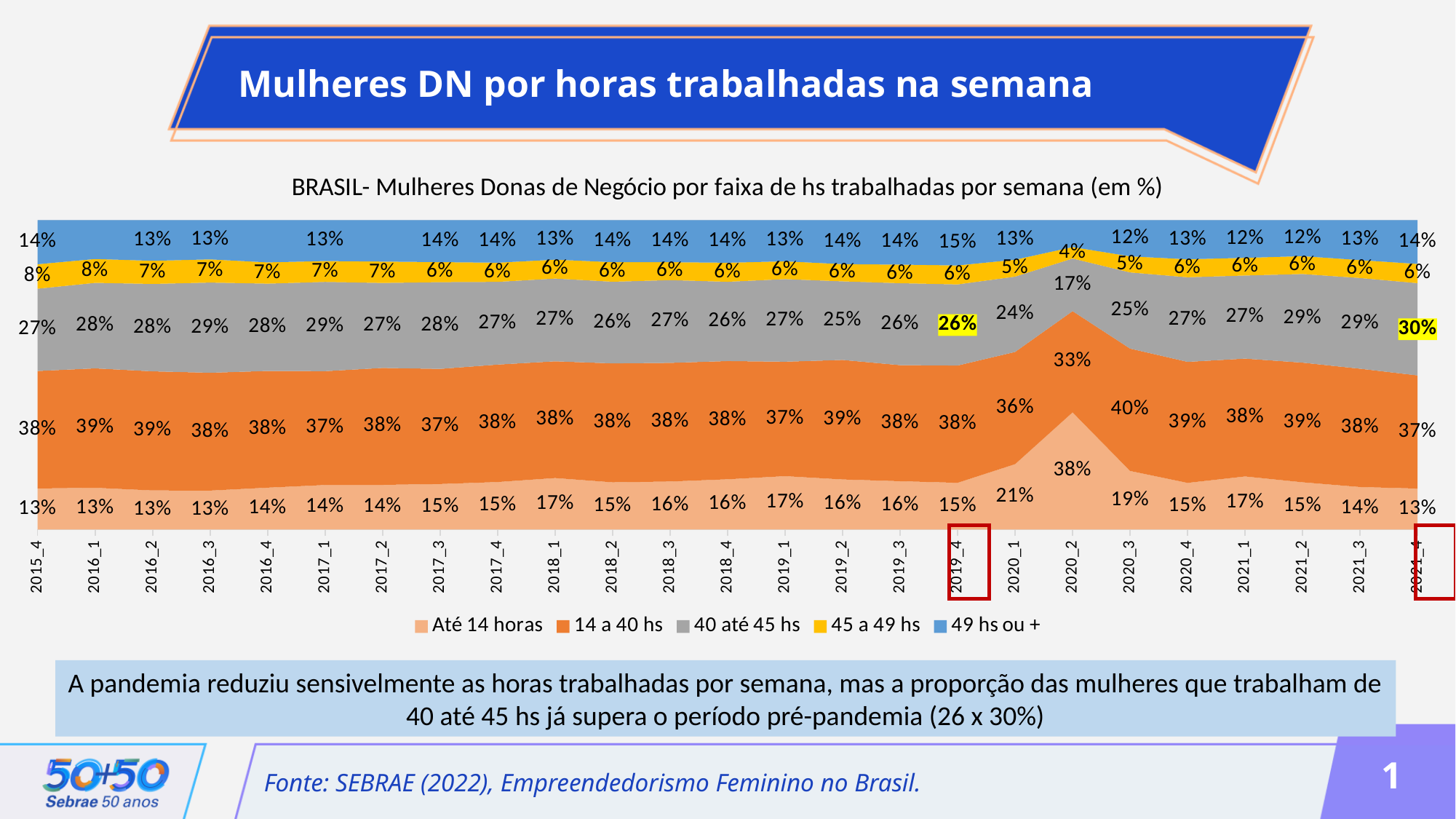
By how many percentage points does the '40 até 45 hs' share in 2021_4 exceed that in 2019_4? 4 percentage points What is the value for '40 até 45 hs' in 2021_4? 30% What is the value for 'Até 14 horas' in 2020_2? 38% Which quarter has the larger '14 a 40 hs' share, 2020_2 or 2020_3? 2020_3 In which quarter is the 'Até 14 horas' share highest? 2020_2 What is the value for '45 a 49 hs' in 2020_2? 4% How many series does the legend list? 5 What is the value for '49 hs ou +' in 2019_4? 15% How many quarters (x-axis categories) are plotted in the chart? 25 In which quarter is the '40 até 45 hs' share lowest? 2020_2 What kind of chart is shown on the slide? Stacked area chart What is the title printed above the chart? BRASIL- Mulheres Donas de Negócio por faixa de hs trabalhadas por semana (em %)